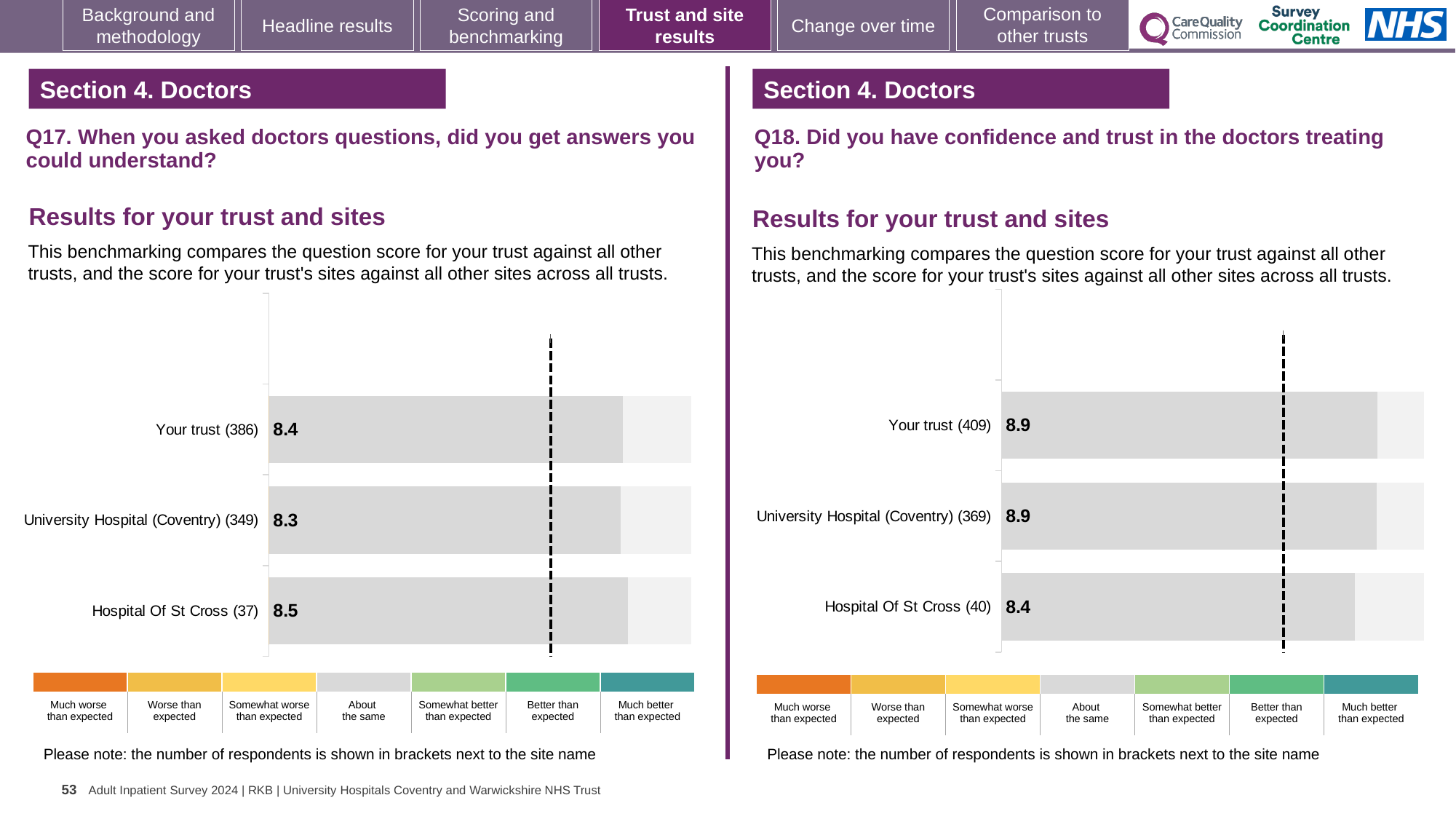
On the Q18 chart (right), what is the score for Hospital Of St Cross? 8.4 How many bars are plotted on the Q17 chart (left)? 3 On the Q17 chart (left), what is the score for Hospital Of St Cross? 8.5 On the Q18 chart (right), how many respondents are shown in brackets for Your trust? 409 On the Q17 chart (left), how many respondents are shown in brackets for University Hospital (Coventry)? 349 On the Q17 chart (left), which site or trust has the lowest score? University Hospital (Coventry) What kind of chart is used on the Q18 chart (right)? Bar chart On the Q18 chart (right), what is the score for Your trust? 8.9 On the Q18 chart (right), which site has the lowest score? Hospital Of St Cross On the Q17 chart (left), what is the score for Your trust? 8.4 On the Q17 chart (left), what is the difference between the scores for Hospital Of St Cross and University Hospital (Coventry)? 0.2 On the Q18 chart (right), what is the difference between the scores for Your trust and Hospital Of St Cross? 0.5